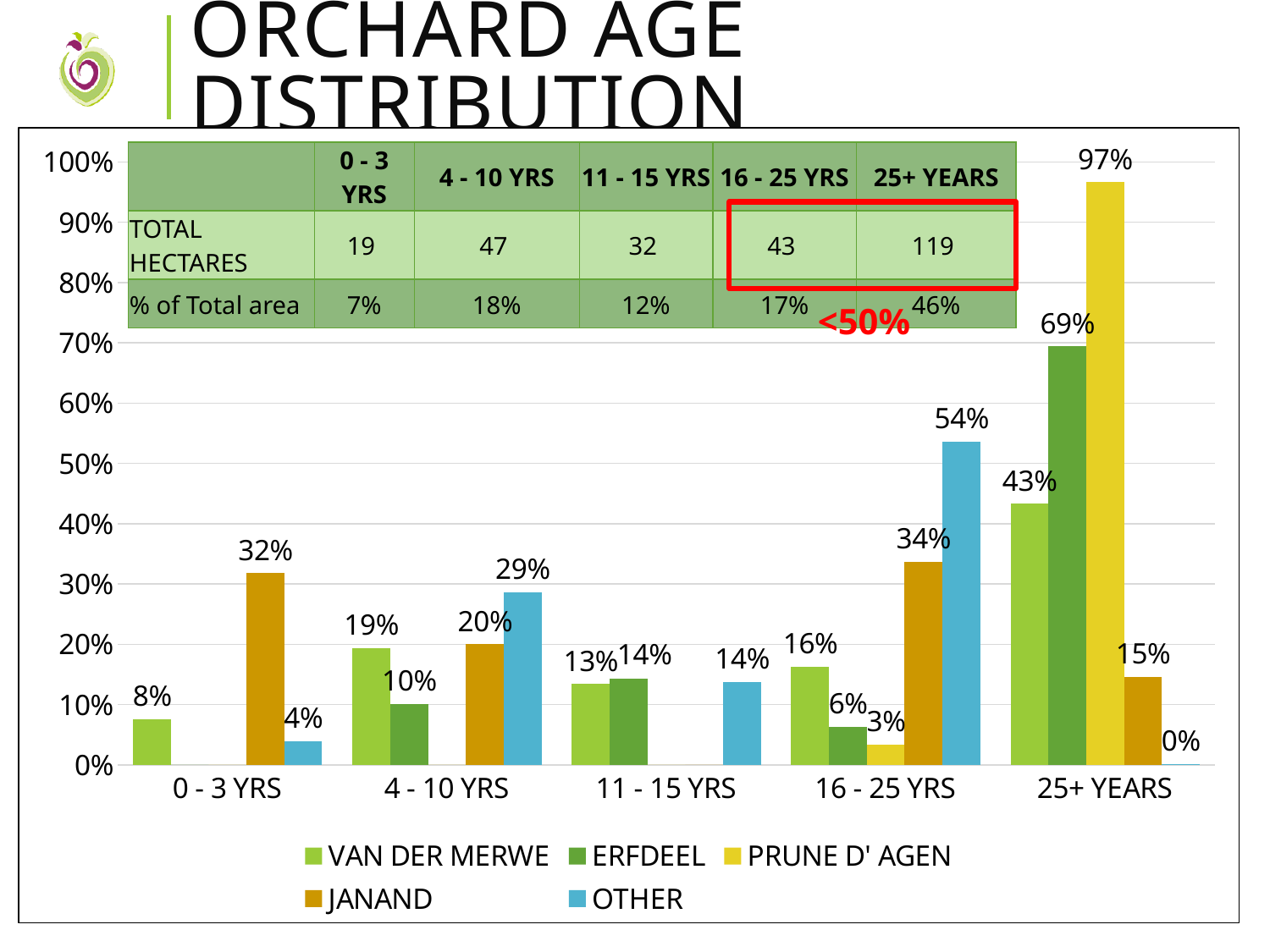
What is the value for PRUNE D' AGEN in the 25+ YEARS category? 97% Which series has the lowest value in the 16 - 25 YRS category? PRUNE D' AGEN Which series has the highest value in the 25+ YEARS category? PRUNE D' AGEN Which is larger: the JANAND value for 16 - 25 YRS or the JANAND value for 0 - 3 YRS? 16 - 25 YRS What is the value for OTHER in the 16 - 25 YRS category? 54% What is the value for JANAND in the 0 - 3 YRS category? 32% What is the difference between the ERFDEEL and VAN DER MERWE values in the 25+ YEARS category? 26% How many age categories are shown on the x axis? 5 Which series is shown in blue in the legend? OTHER How many series does the legend list? 5 What kind of chart is shown on the slide? bar chart What is the value for ERFDEEL in the 4 - 10 YRS category? 10%